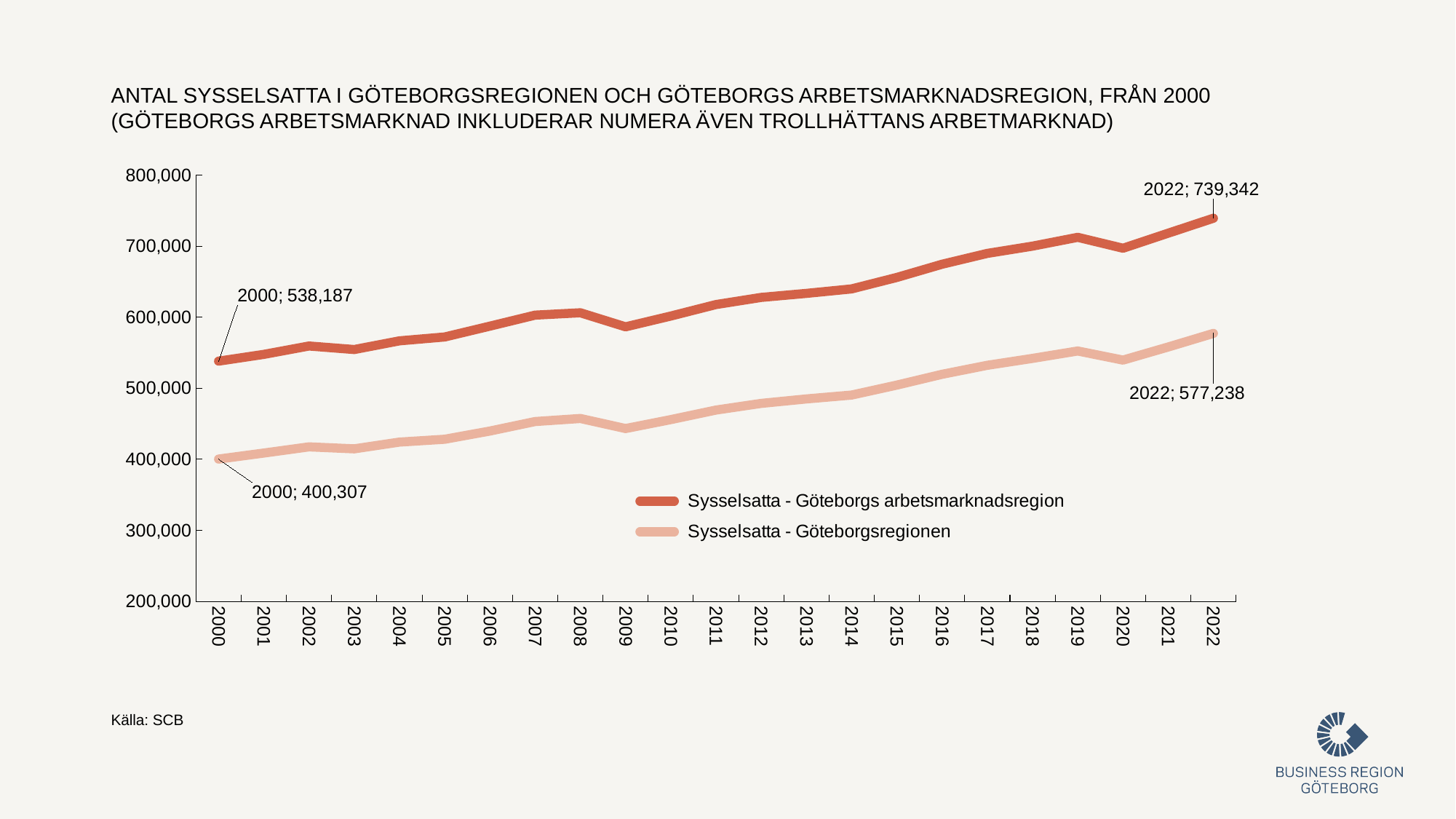
By how much did Sysselsatta - Göteborgs arbetsmarknadsregion increase from 2000 to 2022? 201,155 How many years are plotted along the x axis? 23 Is the value for Sysselsatta - Göteborgs arbetsmarknadsregion in 2009 greater or less than 600,000? less What kind of chart is shown on the slide? Line chart How many series does the legend list? 2 What is the value for Sysselsatta - Göteborgs arbetsmarknadsregion in 2000? 538,187 Which series has the higher value in 2022? Sysselsatta - Göteborgs arbetsmarknadsregion What is the value for Sysselsatta - Göteborgs arbetsmarknadsregion in 2022? 739,342 What is the difference between the two series in 2022? 162,104 Do the values for Sysselsatta - Göteborgsregionen generally rise or fall from 2000 to 2022? rise What is the value for Sysselsatta - Göteborgsregionen in 2000? 400,307 What is the value for Sysselsatta - Göteborgsregionen in 2022? 577,238